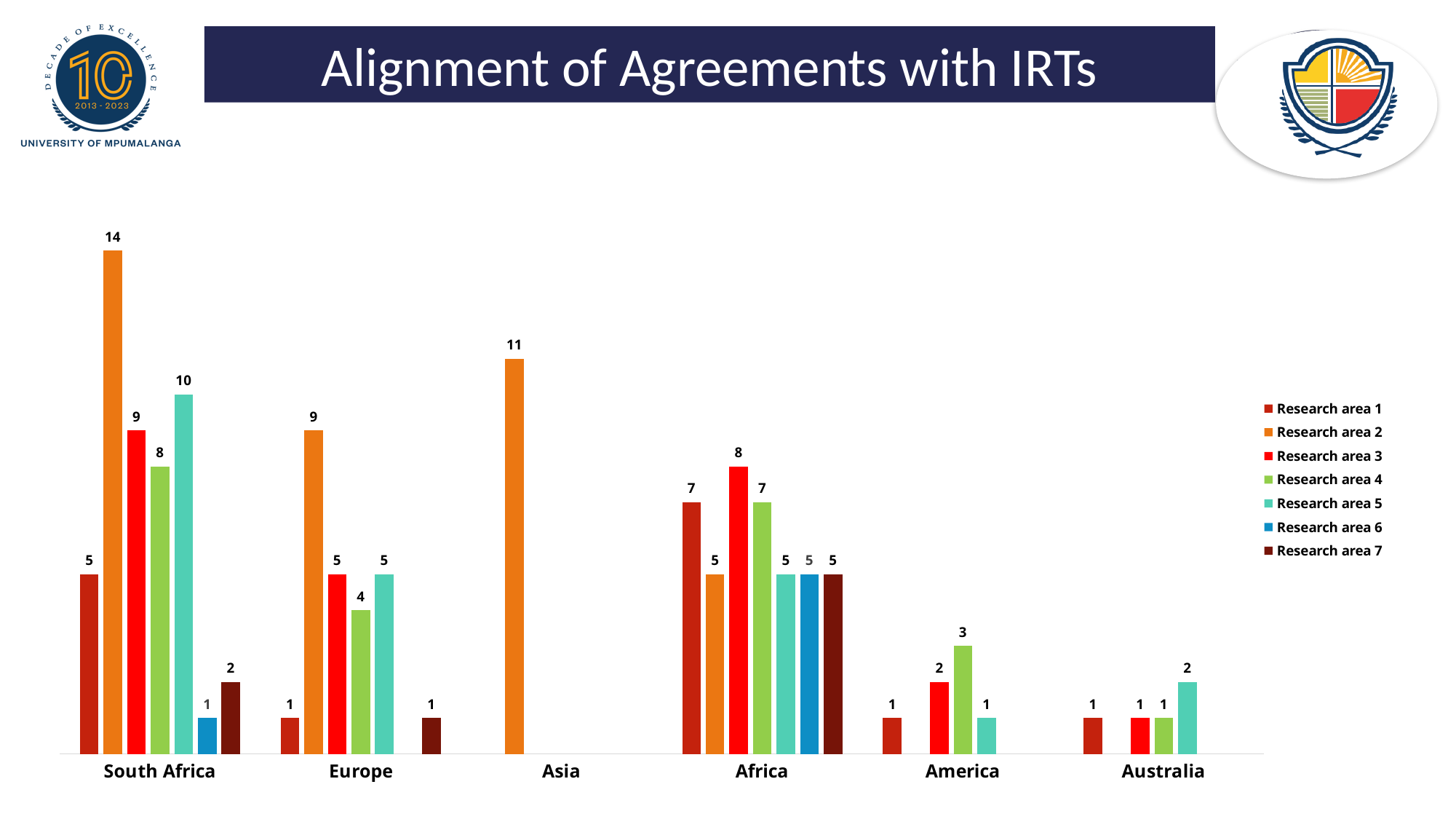
What is the difference between Research area 2 in South Africa and Research area 2 in Europe? 5 Which category has the highest value for Research area 2? South Africa What is the value for Research area 2 in Asia? 11 Which category has the lowest value for Research area 5? America What is the title of the slide? Alignment of Agreements with IRTs How many categories are shown on the x axis? 6 What is the value for Research area 4 in America? 3 How many series does the legend list? 7 What is the value for Research area 3 in Africa? 8 What is the value for Research area 2 in South Africa? 14 What kind of chart is shown on the slide? Bar chart Which is larger: Research area 5 in South Africa or Research area 5 in Africa? Research area 5 in South Africa